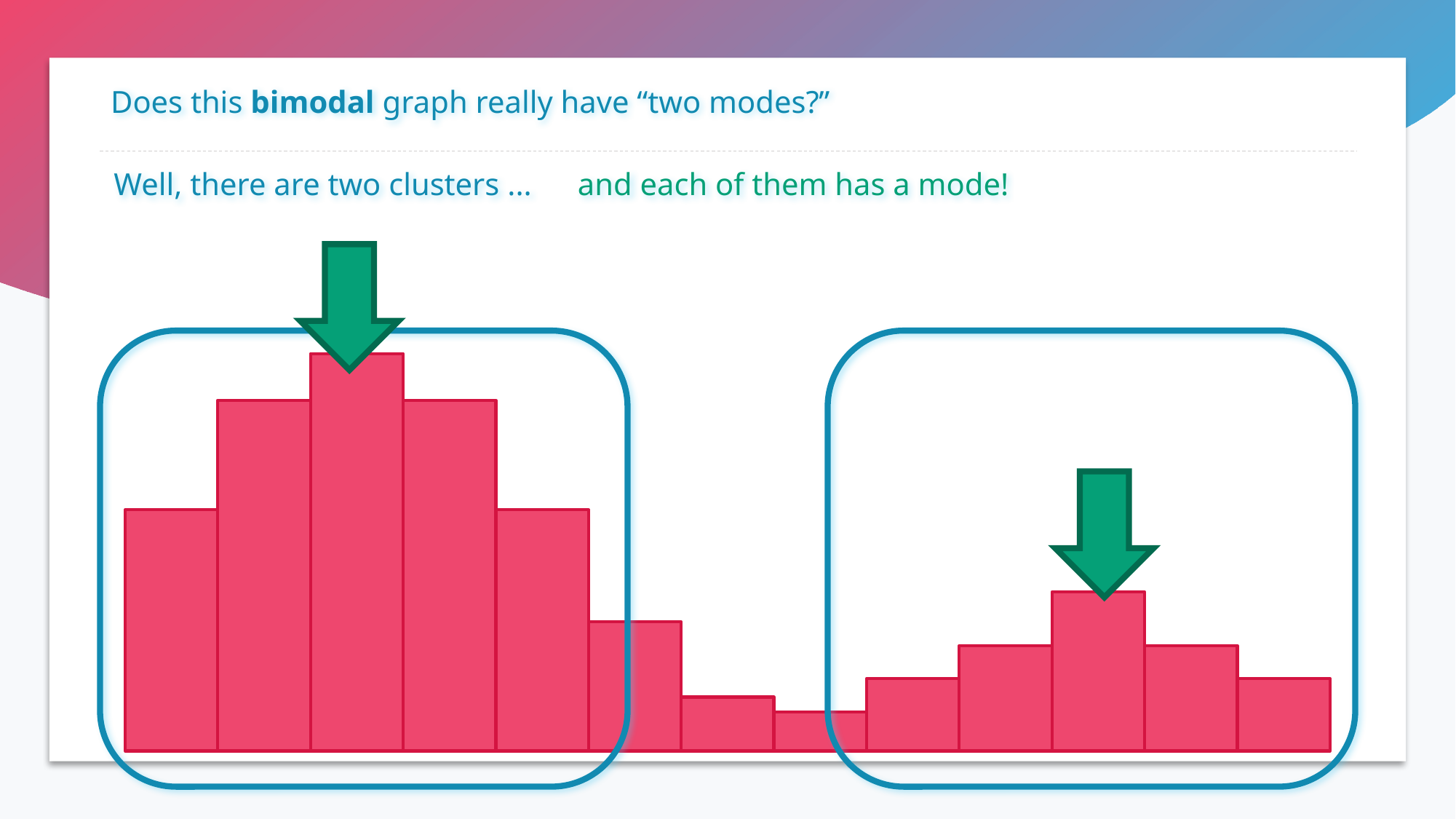
How many bars does the chart contain? 13 Which is taller: the first bar from the left or the last bar on the right? the first bar from the left What kind of chart is shown on the slide? bar chart Which bar is the shortest in the chart? the eighth bar from the left Which bar is the tallest in the chart? the third bar from the left Do the bar heights rise or fall from the first bar to the third bar? rise Which is taller: the peak bar of the left cluster or the peak bar of the right cluster? the peak bar of the left cluster What colour are the bars in the chart? pink/red How many clusters are outlined with rounded boxes on the chart? 2 Do the bar heights rise or fall from the third bar to the eighth bar? fall